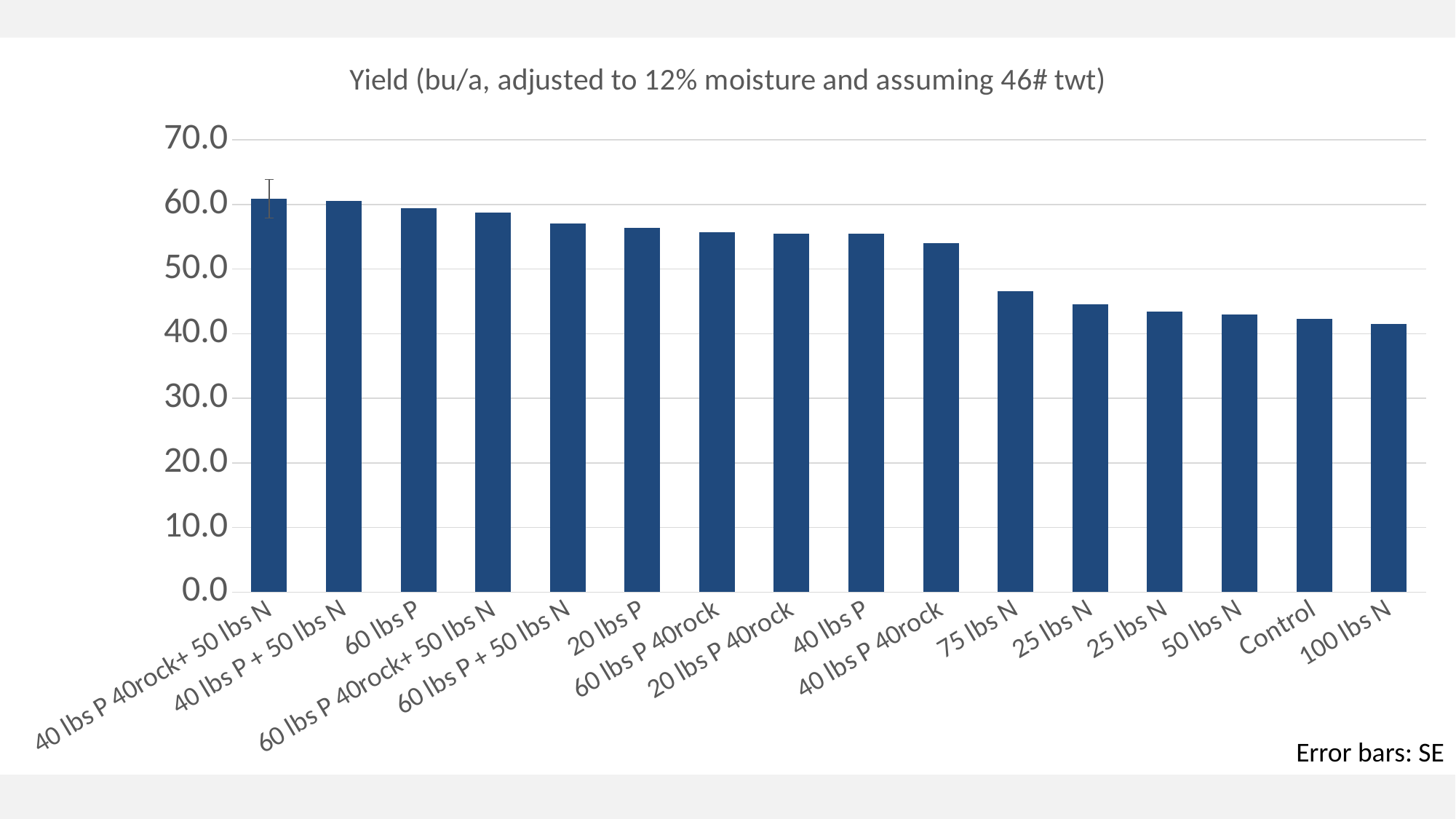
Which has a higher yield, 60 lbs P or 50 lbs N? 60 lbs P Do the bar values generally rise or fall from left to right along the x axis? fall How many treatment categories are plotted on the x axis? 16 What type of chart is shown on the slide? bar chart Is the value for 40 lbs P + 50 lbs N greater or less than 50.0? greater Is the value for 100 lbs N greater or less than 50.0? less Which has a higher yield, 40 lbs P 40rock or 75 lbs N? 40 lbs P 40rock What is the title of the chart? Yield (bu/a, adjusted to 12% moisture and assuming 46# twt) What do the error bars on the chart represent, according to the note on the slide? SE Is the value for 75 lbs N greater or less than 50.0? less